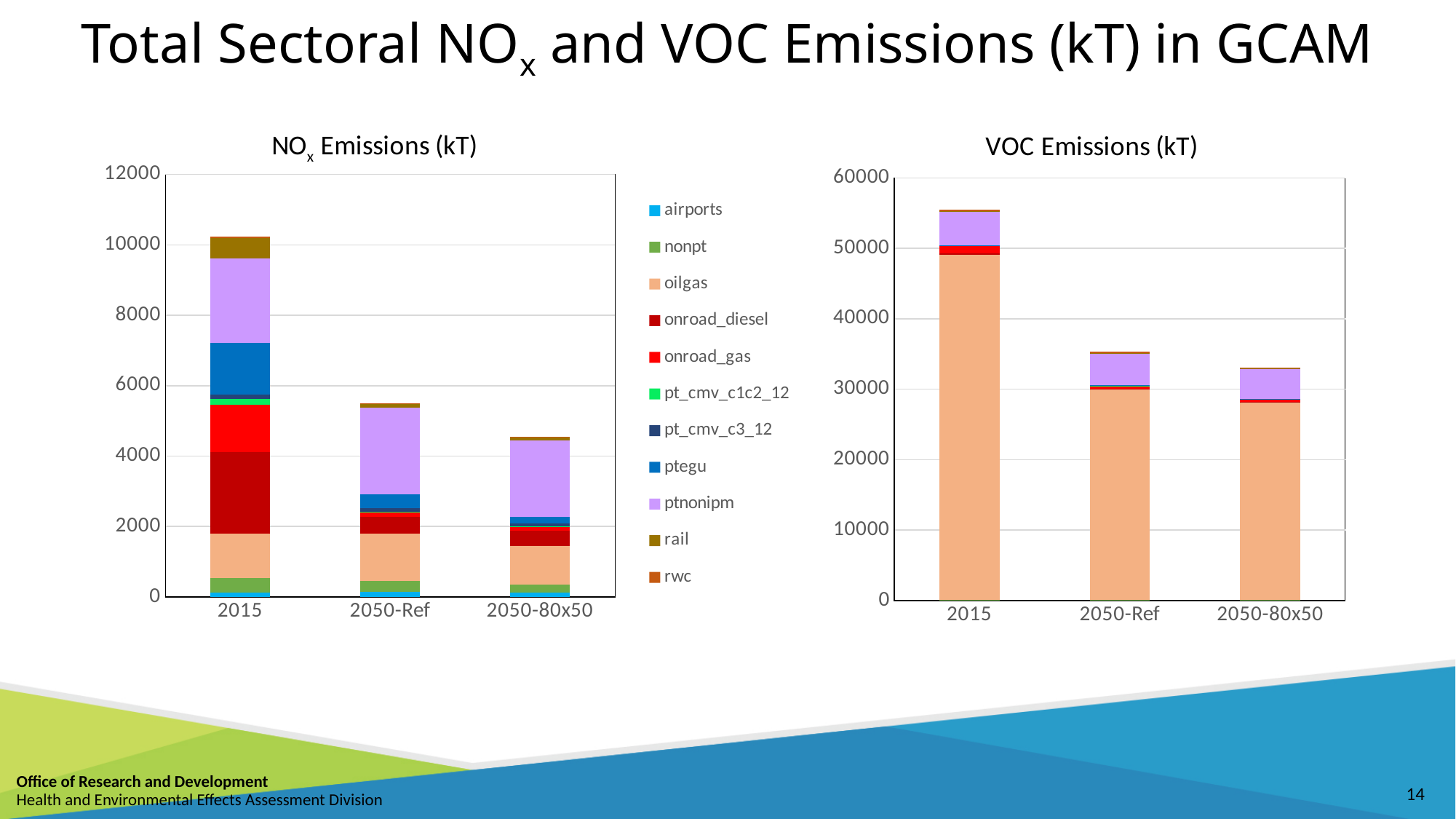
In the VOC Emissions (kT) chart, which scenario has the lowest total emissions? 2050-80x50 In the VOC Emissions (kT) chart, is the total for 2015 greater or less than 50000? greater In the VOC Emissions (kT) chart, is the total for 2050-Ref greater or less than 40000? less What kind of chart is the NOx Emissions (kT) chart? stacked bar chart How many scenario categories are shown on the x axis of the VOC Emissions (kT) chart? 3 Which legend entry is shown in light purple, the largest segment in the 2050 NOx bars? ptnonipm In the NOx Emissions (kT) chart, which scenario has the highest total emissions? 2015 How many series does the legend between the two charts list? 11 In the NOx Emissions (kT) chart, which scenario has the lowest total emissions? 2050-80x50 In the NOx Emissions (kT) chart, is the total for 2015 greater or less than 10000? greater In the NOx Emissions (kT) chart, do total emissions rise or fall from 2015 to 2050-80x50? fall In the VOC Emissions (kT) chart, which scenario has the highest total emissions? 2015